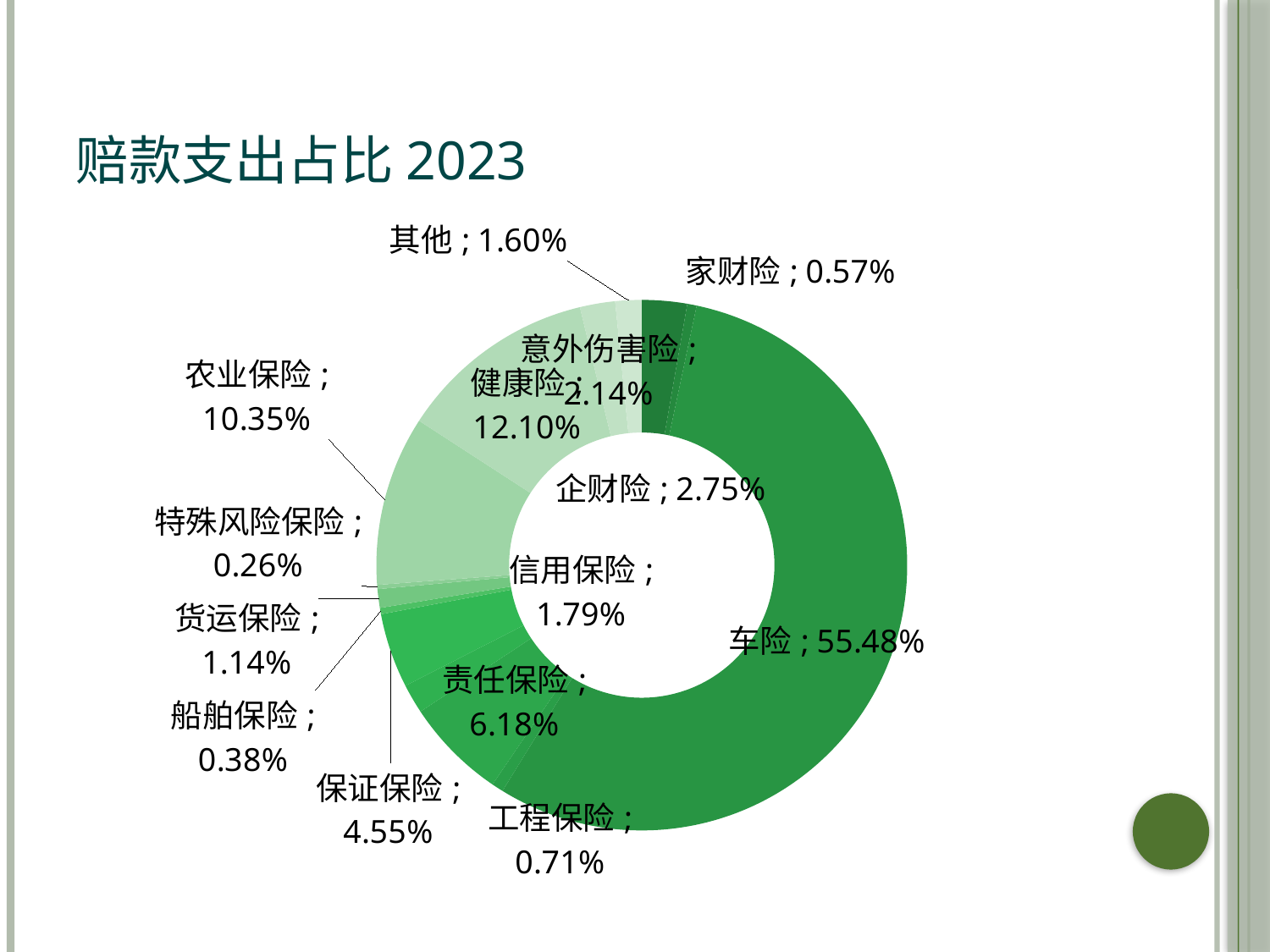
What is the value shown for 健康险? 12.10% Which category has the smallest share in the chart? 特殊风险保险 Which has a larger share, 责任保险 or 保证保险? 责任保险 What percentage is shown for 农业保险? 10.35% How many categories are shown in the chart? 14 What kind of chart is shown on the slide? Doughnut (pie) chart What is the value for 保证保险? 4.55% What is the title of the chart? 赔款支出占比 2023 Which category has the largest share in the chart? 车险 What share of claims expenditure does 车险 account for? 55.48% What is the difference between the shares of 健康险 and 农业保险? 1.75% Which has a larger share, 企财险 or 意外伤害险? 企财险